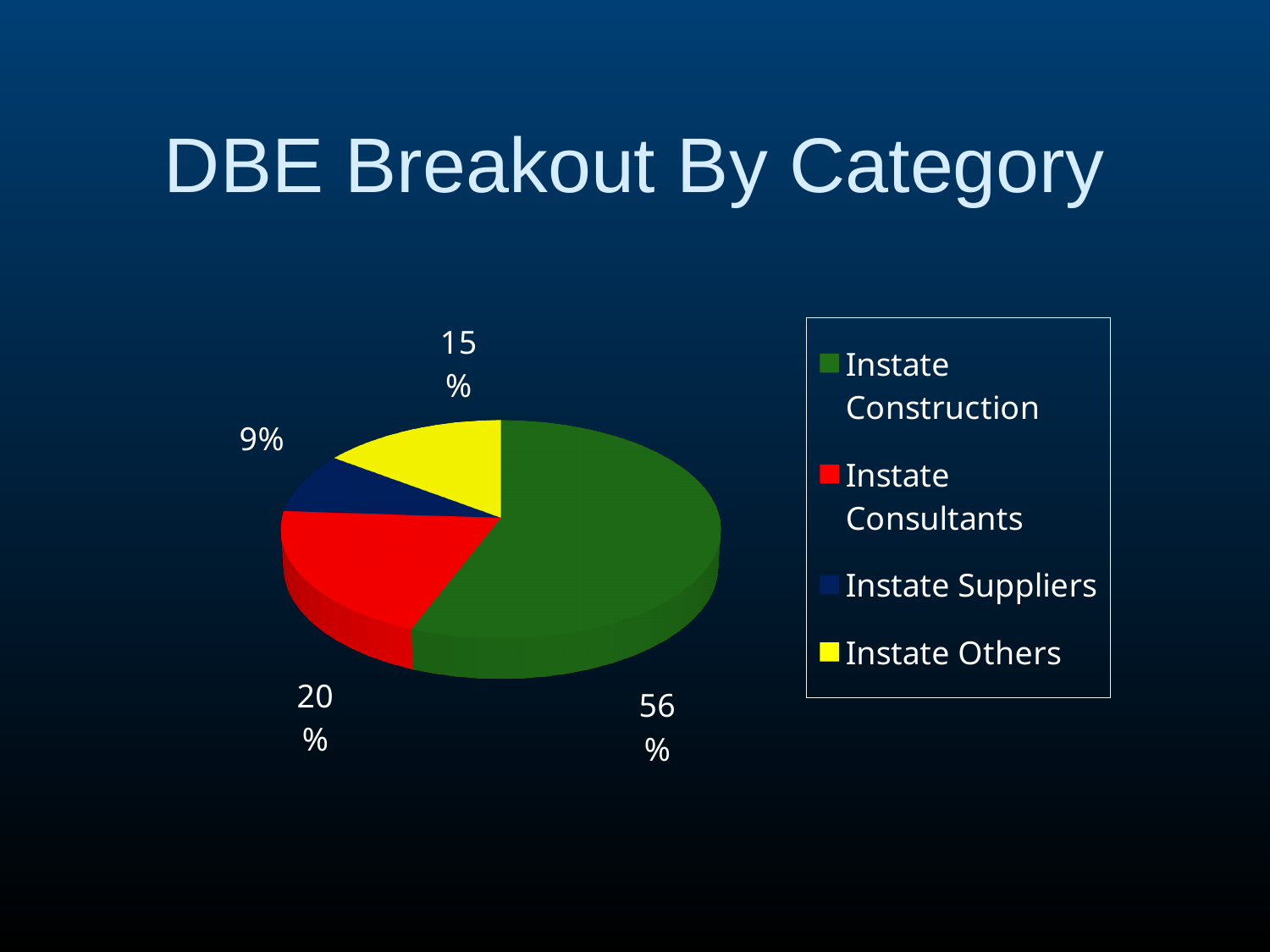
What is the difference in percentage points between Instate Others and Instate Suppliers? 6 Which category has the smallest slice of the pie? Instate Suppliers What is the difference in percentage points between Instate Construction and Instate Consultants? 36 What share of the pie does Instate Others represent? 15% What kind of chart is shown on the slide? Pie chart Which is larger, the share for Instate Consultants or the share for Instate Others? Instate Consultants Which category has the largest slice of the pie? Instate Construction What share of the pie does Instate Consultants represent? 20% How many categories are shown in the pie chart? 4 What is the title of the chart? DBE Breakout By Category What share of the pie does Instate Construction represent? 56%